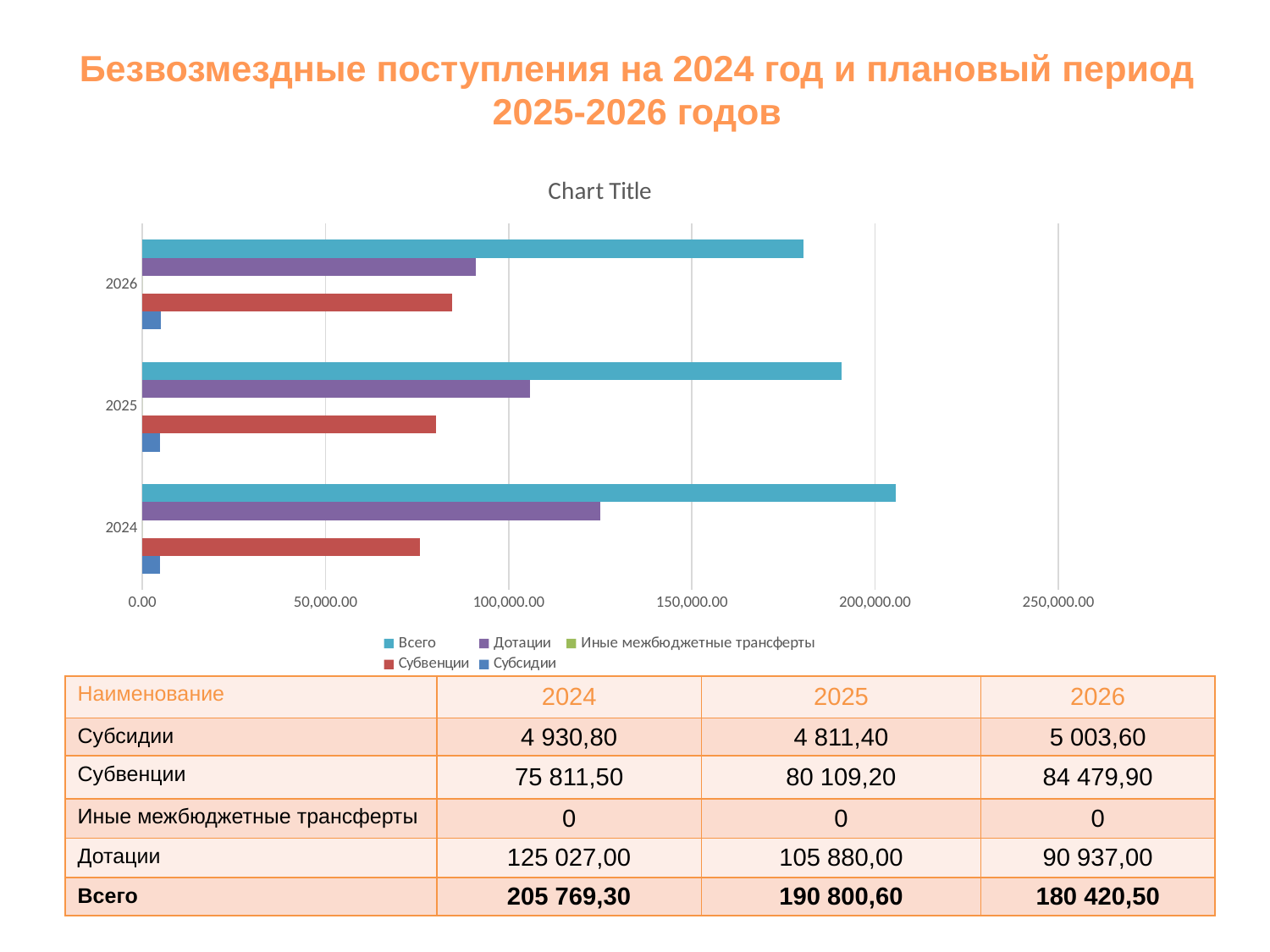
What is the difference between Всего for 2024 and Всего for 2026? 25 348,80 Which year has the lowest value for Субвенции? 2024 What kind of chart is shown on the slide? bar chart Is the value of Всего for 2025 greater or less than 150,000.00? greater In 2024, which is larger: Дотации or Субвенции? Дотации How many years (categories) are plotted on the chart? 3 Does the value of Всего rise or fall from 2024 to 2026? fall Which year has the highest value for Всего? 2024 What is the value of Всего for 2024? 205 769,30 What title is displayed above the chart? Chart Title How many series does the chart legend list? 5 What is the value of Субвенции for 2026? 84 479,90